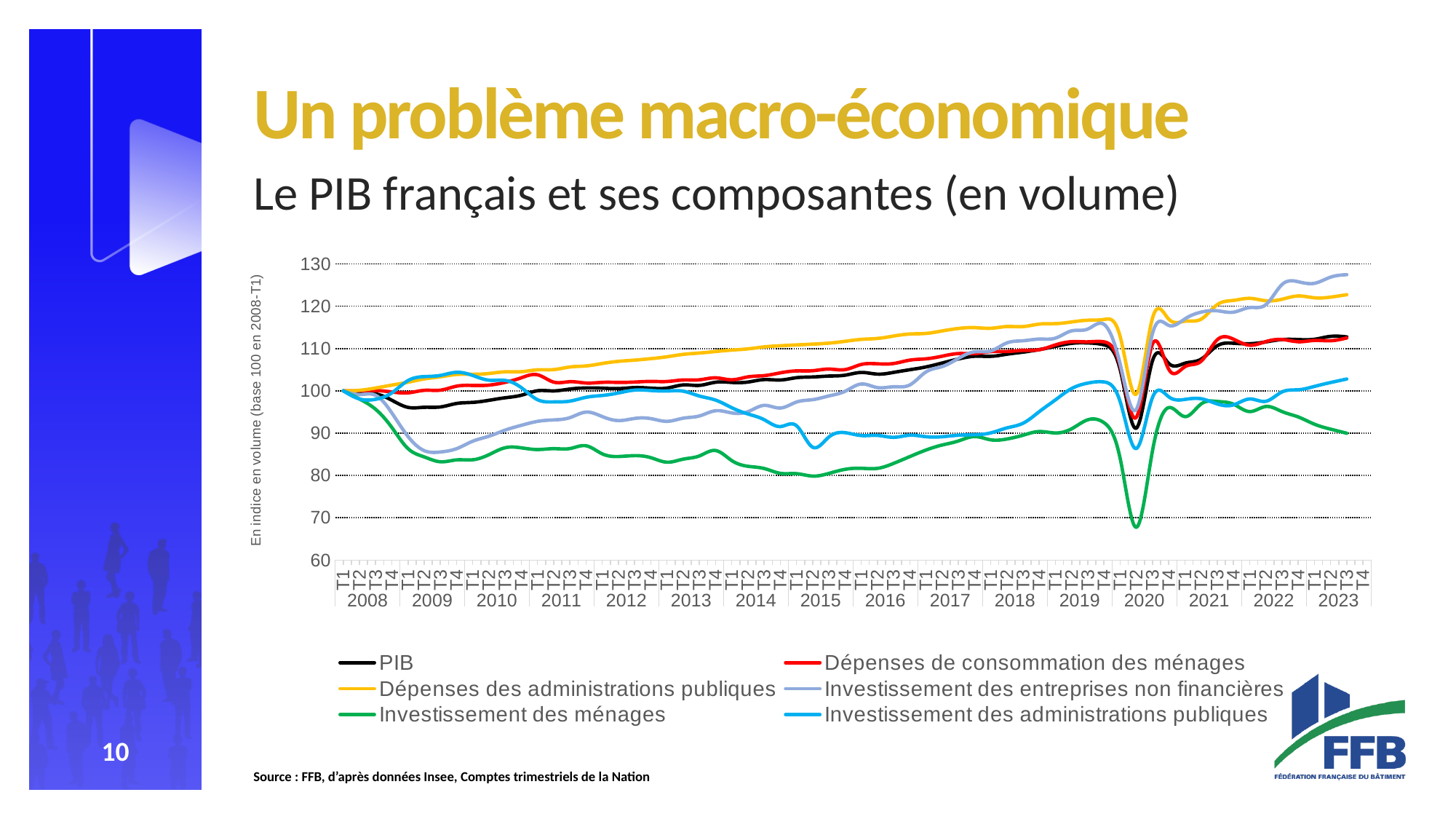
What is the value of the PIB series at 2008 T1? 100 Is the value for PIB in 2023 T3 greater or less than 110? greater What kind of chart is shown on the slide? line chart Does the Dépenses des administrations publiques series generally rise or fall from 2008 to 2023? rise Which series is drawn in green? Investissement des ménages Is the value for Investissement des ménages in 2020 T2 greater or less than 70? less How many years are labelled on the x axis? 16 Which series has the lowest value in 2020 T2? Investissement des ménages Which series has the highest value at 2023 T3? Investissement des entreprises non financières Is the value for Dépenses des administrations publiques in 2023 T3 greater or less than 120? greater How many series does the legend list? 6